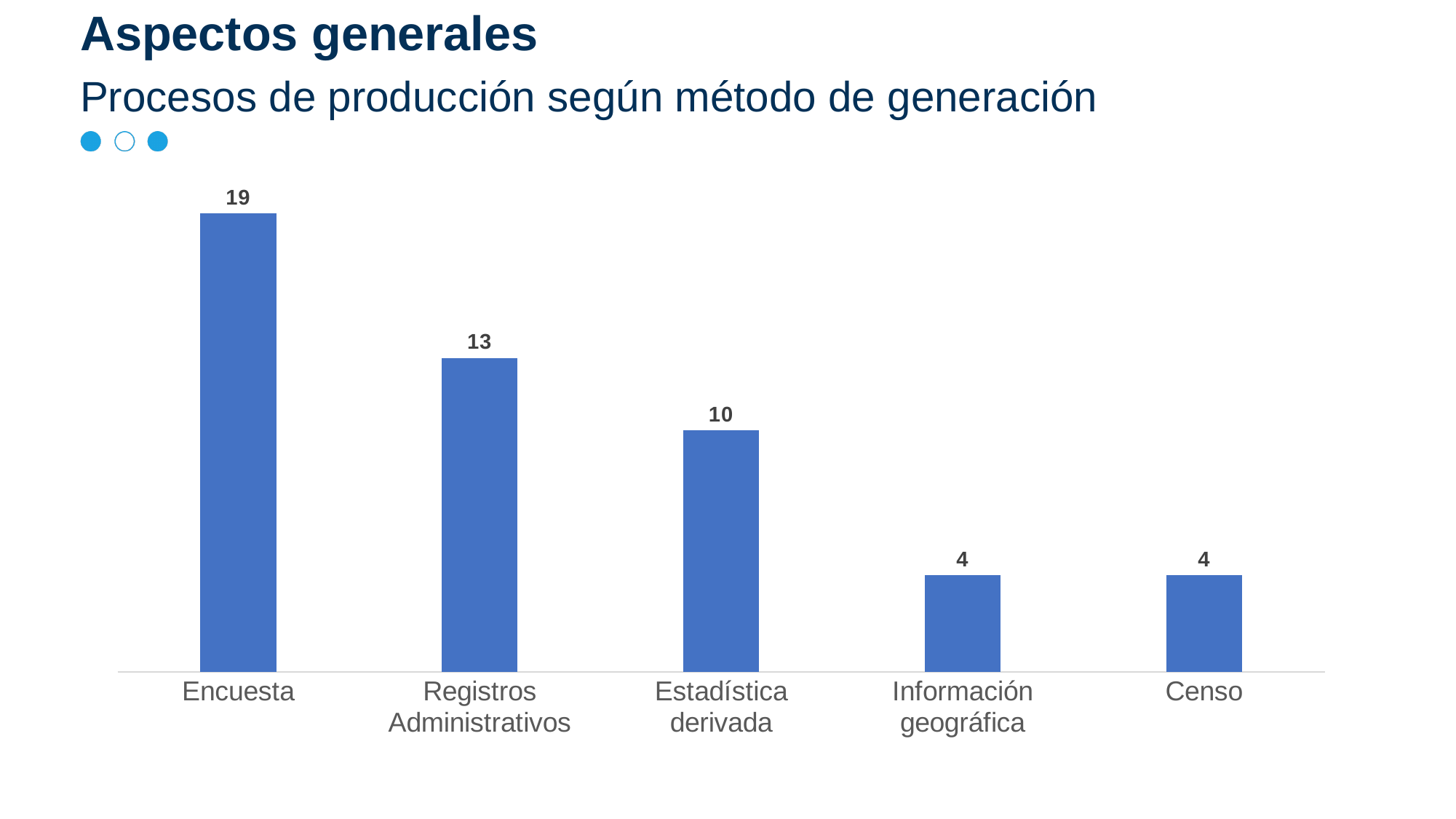
What kind of chart is shown on the slide? Bar chart What is the difference between the values for Registros Administrativos and Estadística derivada? 3 What is the value for Censo? 4 What is the value for Estadística derivada? 10 What is the value for Registros Administrativos? 13 What is the subtitle of the slide describing the chart? Procesos de producción según método de generación What is the value for Encuesta? 19 Do the values rise or fall from left to right along the x axis? Fall What is the difference between the values for Encuesta and Registros Administrativos? 6 Which category has the highest value? Encuesta Which is larger, the value for Estadística derivada or the value for Información geográfica? Estadística derivada How many categories are shown on the x axis? 5